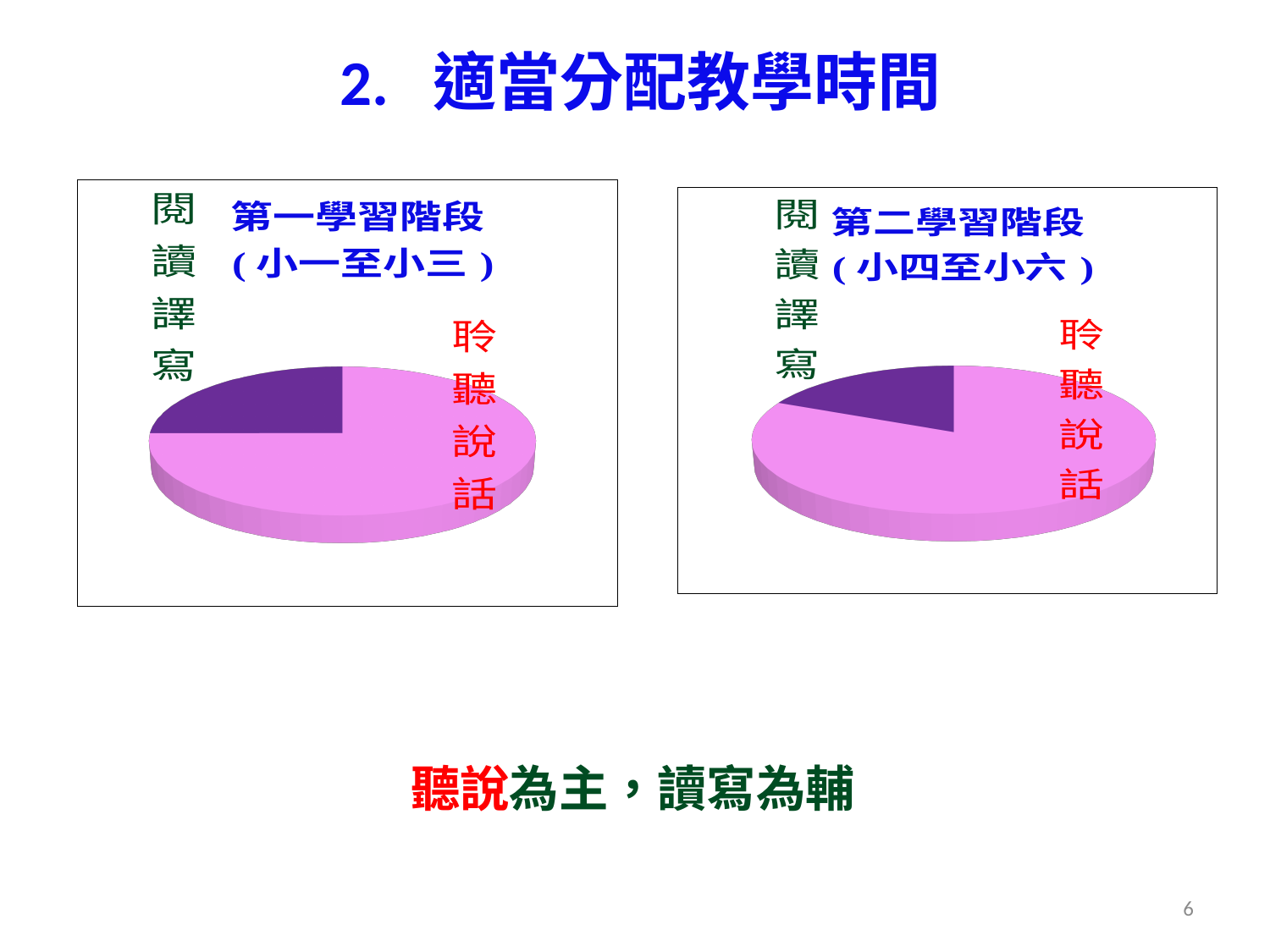
In the left chart (第一學習階段), which is larger: the slice for 閱讀譯寫 or the slice for 聆聽說話? 聆聽說話 In the right chart (第二學習階段), which category has the smallest slice? 閱讀譯寫 In the left chart (第一學習階段), which category has the largest slice? 聆聽說話 In the right chart (第二學習階段), which is larger: the slice for 閱讀譯寫 or the slice for 聆聽說話? 聆聽說話 In the right chart (第二學習階段), what colour is the slice for 閱讀譯寫? dark purple What kind of chart is the right chart titled 第二學習階段（小四至小六）? pie chart In the left chart (第一學習階段), how many slices does the pie have? 2 What kind of chart is the left chart titled 第一學習階段（小一至小三）? pie chart In the left chart (第一學習階段), which category has the smallest slice? 閱讀譯寫 In the right chart (第二學習階段), which category has the largest slice? 聆聽說話 What is the title of the chart on the left of the slide? 第一學習階段（小一至小三） In the right chart (第二學習階段), how many slices does the pie have? 2